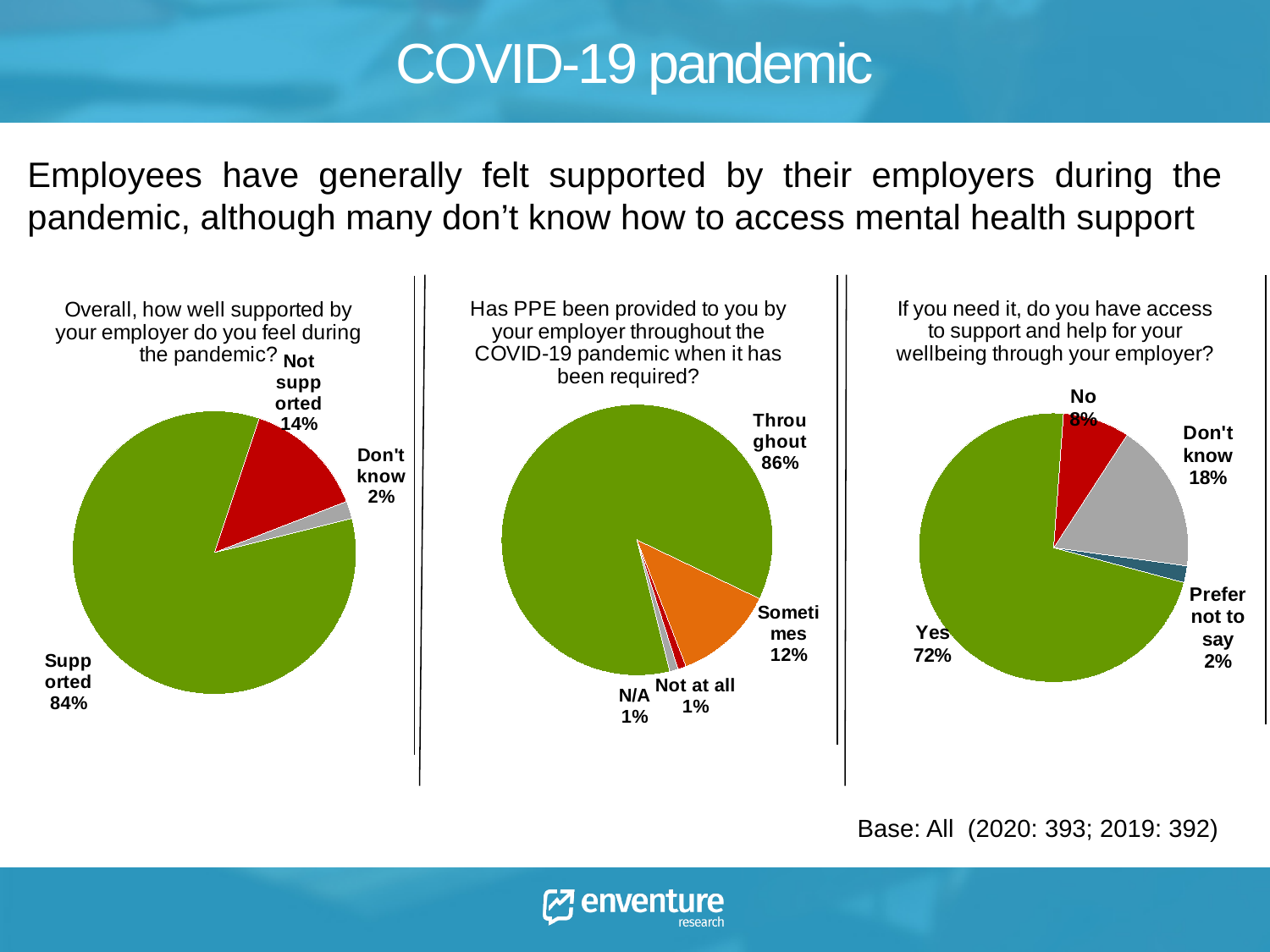
In the left pie chart (Overall, how well supported by your employer do you feel during the pandemic?), what percentage of employees felt supported? 84% In the middle pie chart (Has PPE been provided...), what percentage answered 'Sometimes'? 12% In the right pie chart (If you need it, do you have access to support...), what percentage answered 'Prefer not to say'? 2% What type of chart is used for all three charts on the slide? Pie chart How many pie charts are shown on the slide? 3 In the left pie chart (Overall, how well supported...), which is larger: 'Not supported' or 'Don't know'? Not supported In the right pie chart (If you need it, do you have access to support...), what is the difference between the 'Yes' share and the 'No' share? 64% In the right pie chart (If you need it, do you have access to support and help for your wellbeing through your employer?), what percentage answered 'Don't know'? 18% In the middle pie chart (Has PPE been provided...), how many response categories are shown? 4 In the left pie chart (Overall, how well supported by your employer do you feel during the pandemic?), what percentage answered 'Not supported'? 14% In the right pie chart (If you need it, do you have access to support...), which response has the largest share? Yes In the middle pie chart (Has PPE been provided to you by your employer throughout the COVID-19 pandemic when it has been required?), what percentage answered 'Throughout'? 86%